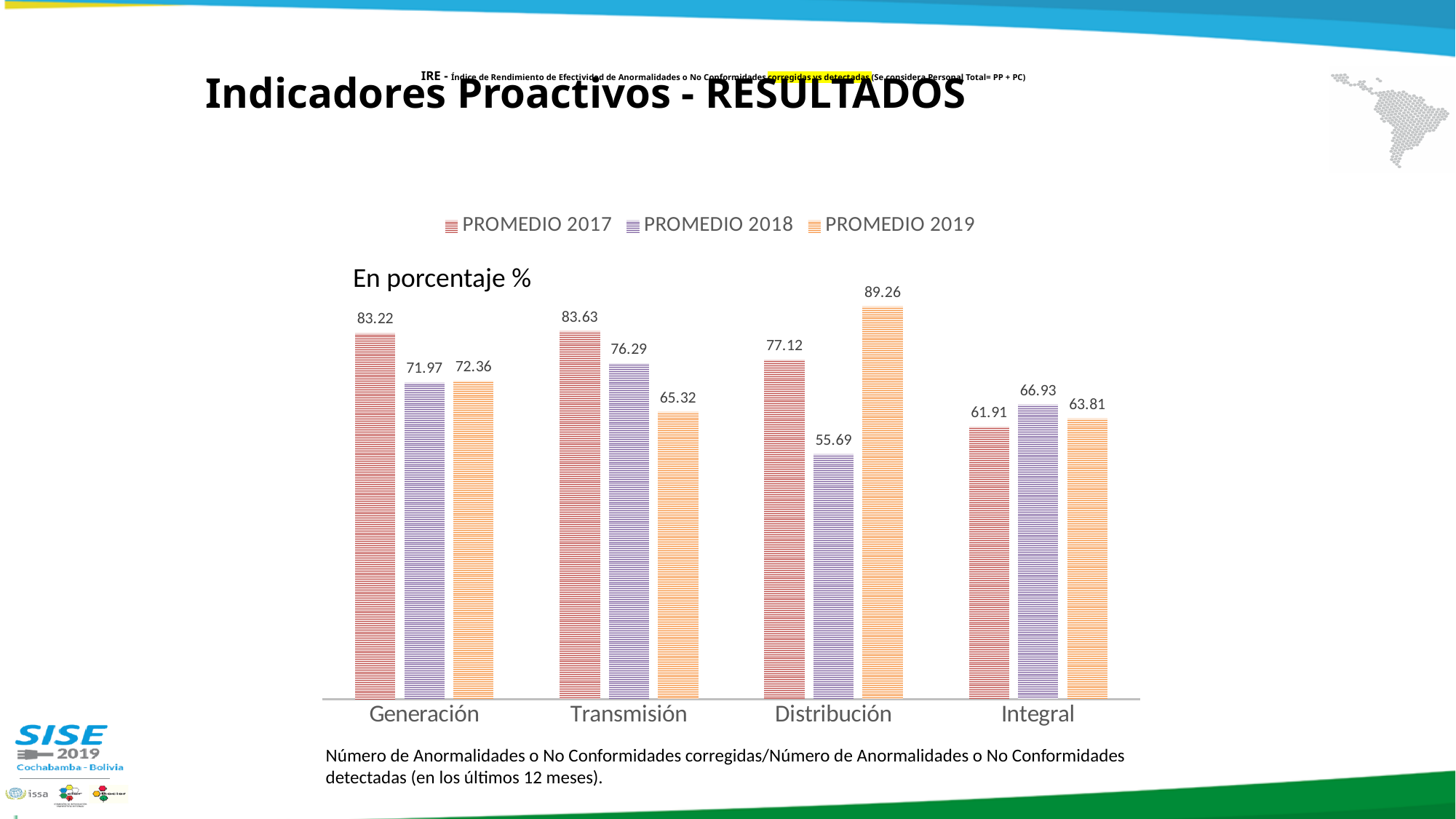
What unit label is shown above the chart? En porcentaje % How many series does the legend list? 3 Which is larger for Integral: PROMEDIO 2017 or PROMEDIO 2019? PROMEDIO 2019 How many categories are shown on the x axis? 4 Which category has the highest PROMEDIO 2017 value? Transmisión What is the PROMEDIO 2019 value for Distribución? 89.26 What is the PROMEDIO 2017 value for Generación? 83.22 What is the difference between the PROMEDIO 2019 and PROMEDIO 2018 values for Distribución? 33.57 What kind of chart is shown on the slide? Bar chart What is the PROMEDIO 2018 value for Integral? 66.93 What is the PROMEDIO 2019 value for Transmisión? 65.32 Which category has the lowest PROMEDIO 2018 value? Distribución